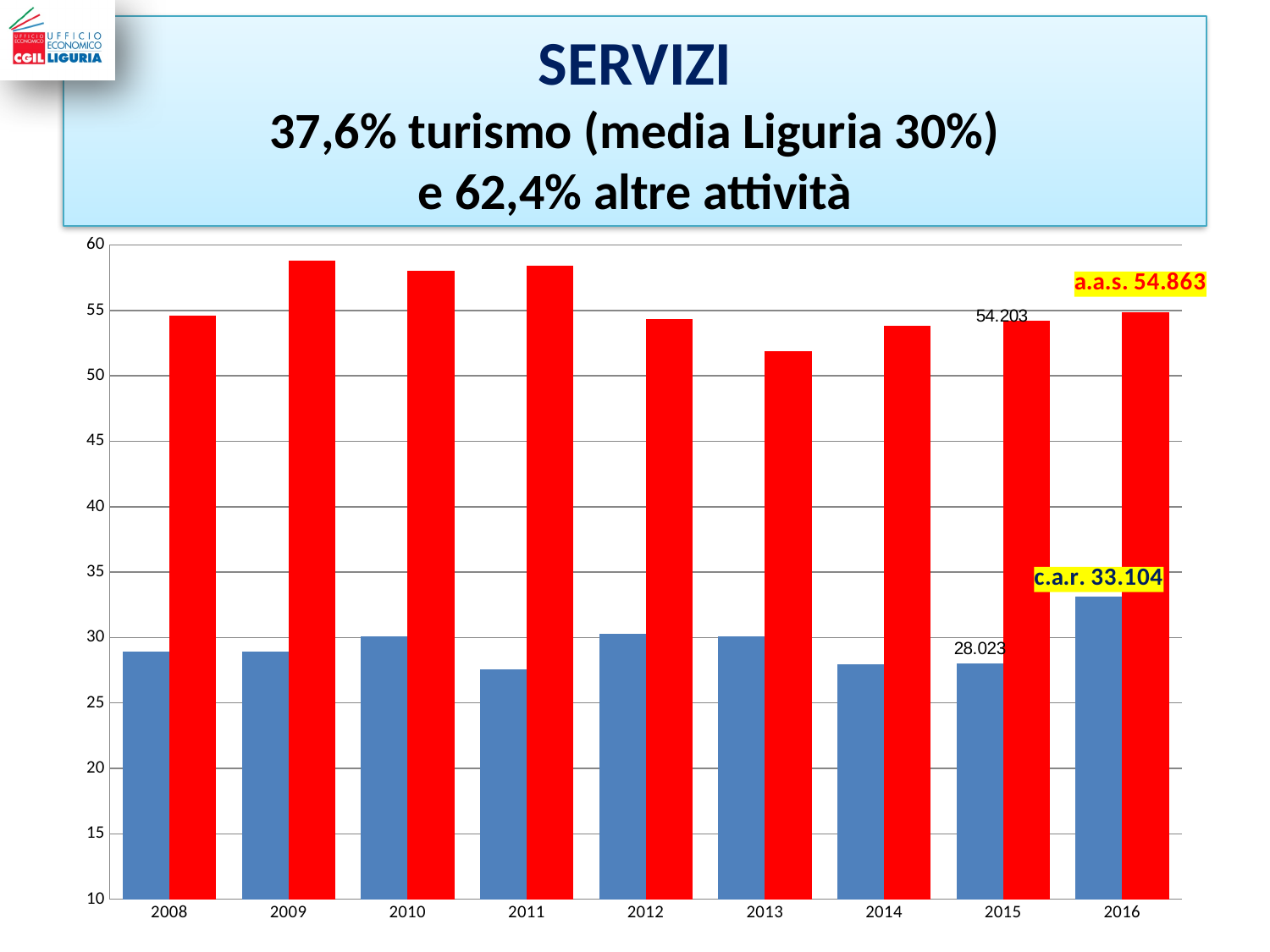
What is the main title shown at the top of the slide? SERVIZI What is the value labelled c.a.r. for 2016? 33.104 What is the value of the red bar for 2015? 54.203 How many years are shown on the x axis of the chart? 9 Which year has the highest blue bar? 2016 What is the value of the blue bar for 2015? 28.023 Which is larger, the red bar for 2009 or the red bar for 2013? 2009 What is the value labelled a.a.s. for 2016? 54.863 Which year has the lowest red bar? 2013 What kind of chart is shown on the slide? bar chart Is the blue bar for 2011 greater or less than 30? less By how much does the blue bar for 2016 (33.104) exceed the blue bar for 2015 (28.023)? 5.081